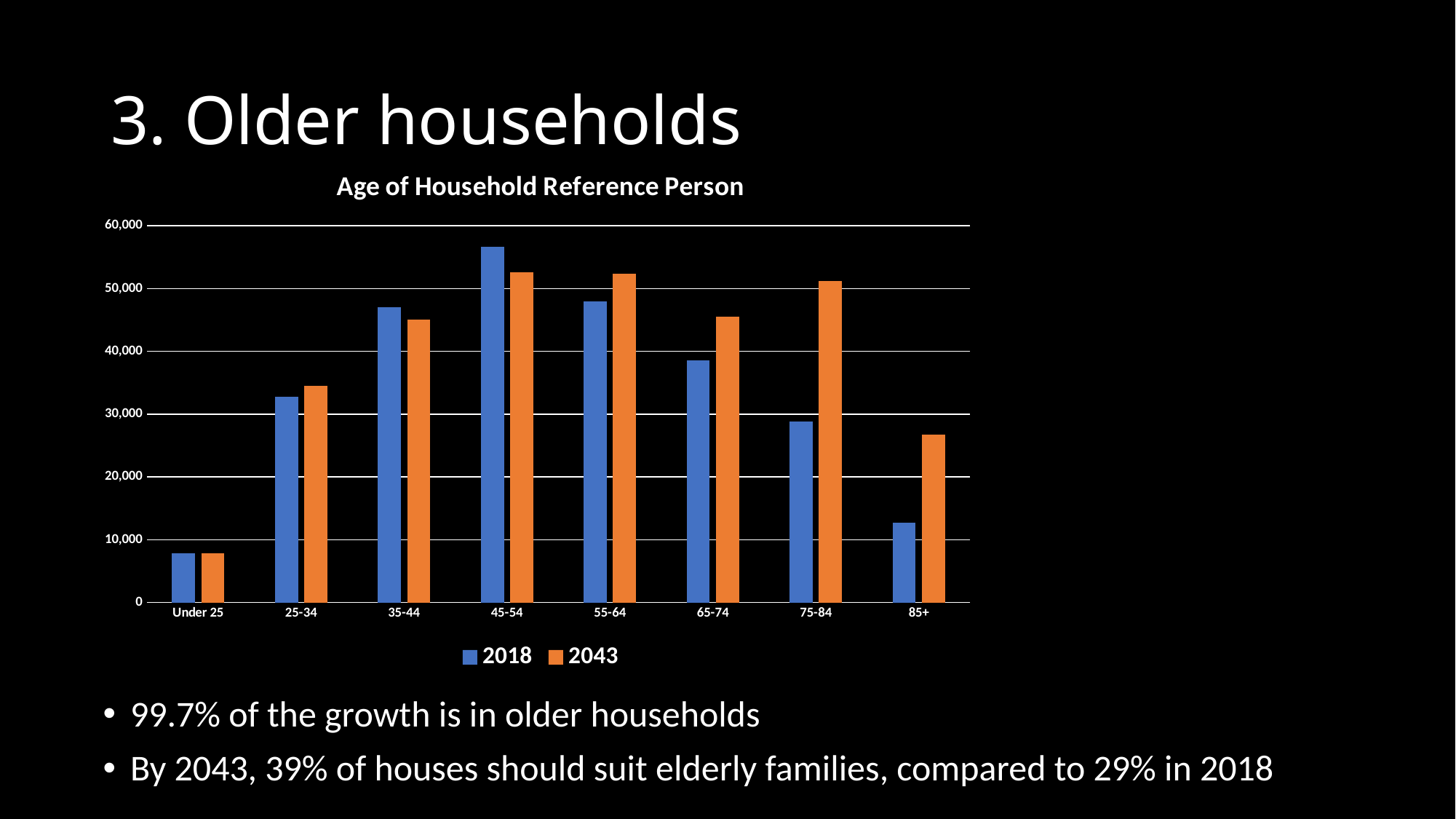
For the 75-84 category, which series has the larger value, 2018 or 2043? 2043 Which age category has the highest value for 2018? 45-54 What kind of chart is shown on the slide? bar chart Is the 2043 value for 85+ greater or less than 30,000? less Which age category has the lowest value for 2043? Under 25 Is the 2043 value for 75-84 greater or less than 50,000? greater Is the 2018 value for 45-54 greater or less than 50,000? greater What is the title of the chart? Age of Household Reference Person How many series does the legend list? 2 For the 45-54 category, which series has the larger value, 2018 or 2043? 2018 How many age categories are shown on the x axis? 8